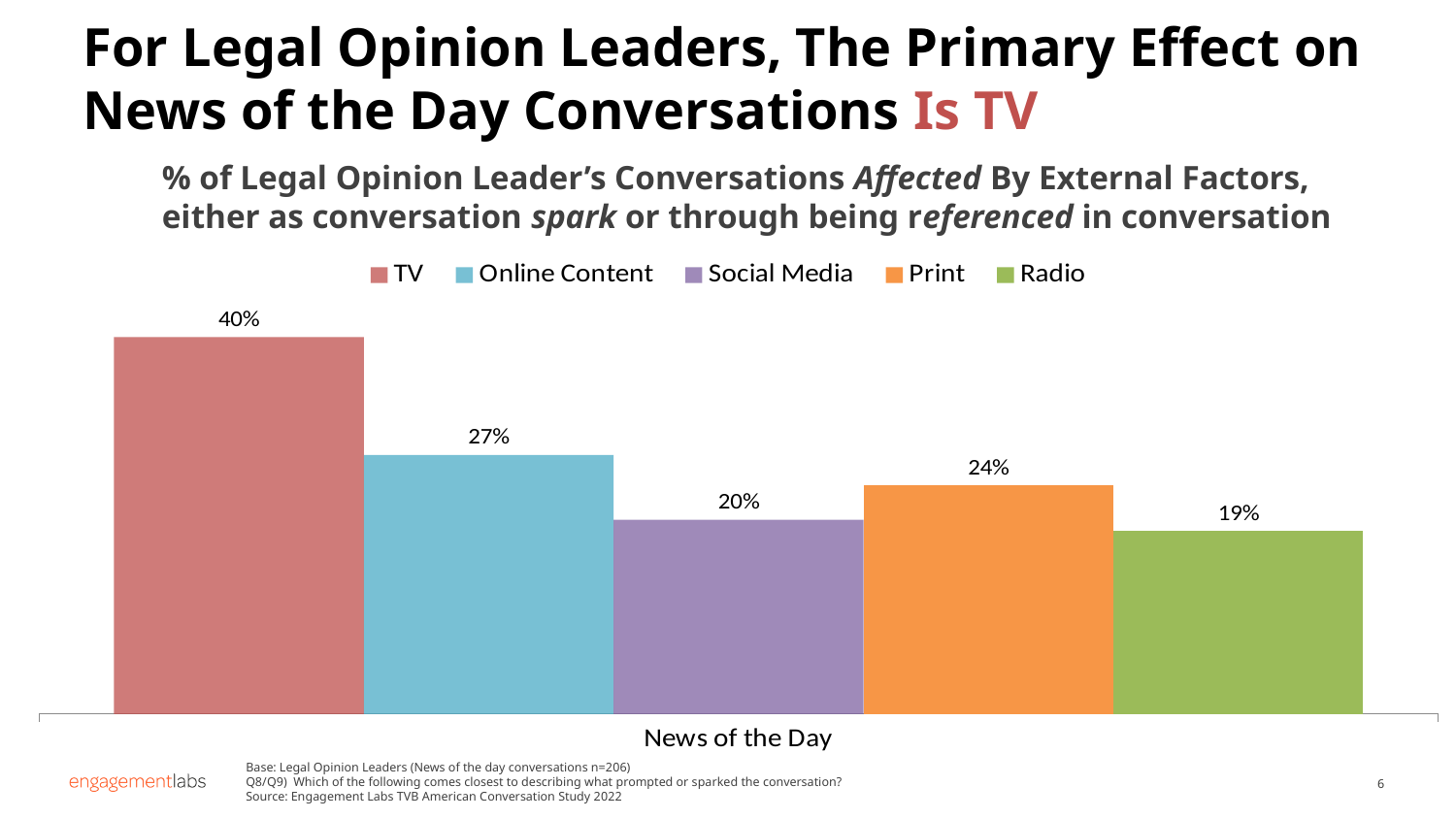
Which external factor has the lowest value in the chart? Radio What is the category label shown on the x axis of the chart? News of the Day What kind of chart is shown on the slide? Bar chart What is the value shown for Radio? 19% What is the value shown for Online Content? 27% What is the difference between the values for TV and Online Content? 13% Which external factor has the highest value in the chart? TV How many series does the legend list? 5 What is the difference between the values for Print and Social Media? 4% What percentage of Legal Opinion Leaders' News of the Day conversations is affected by TV? 40% Which is larger, the value for Print or the value for Social Media? Print What is the value shown for Social Media? 20%